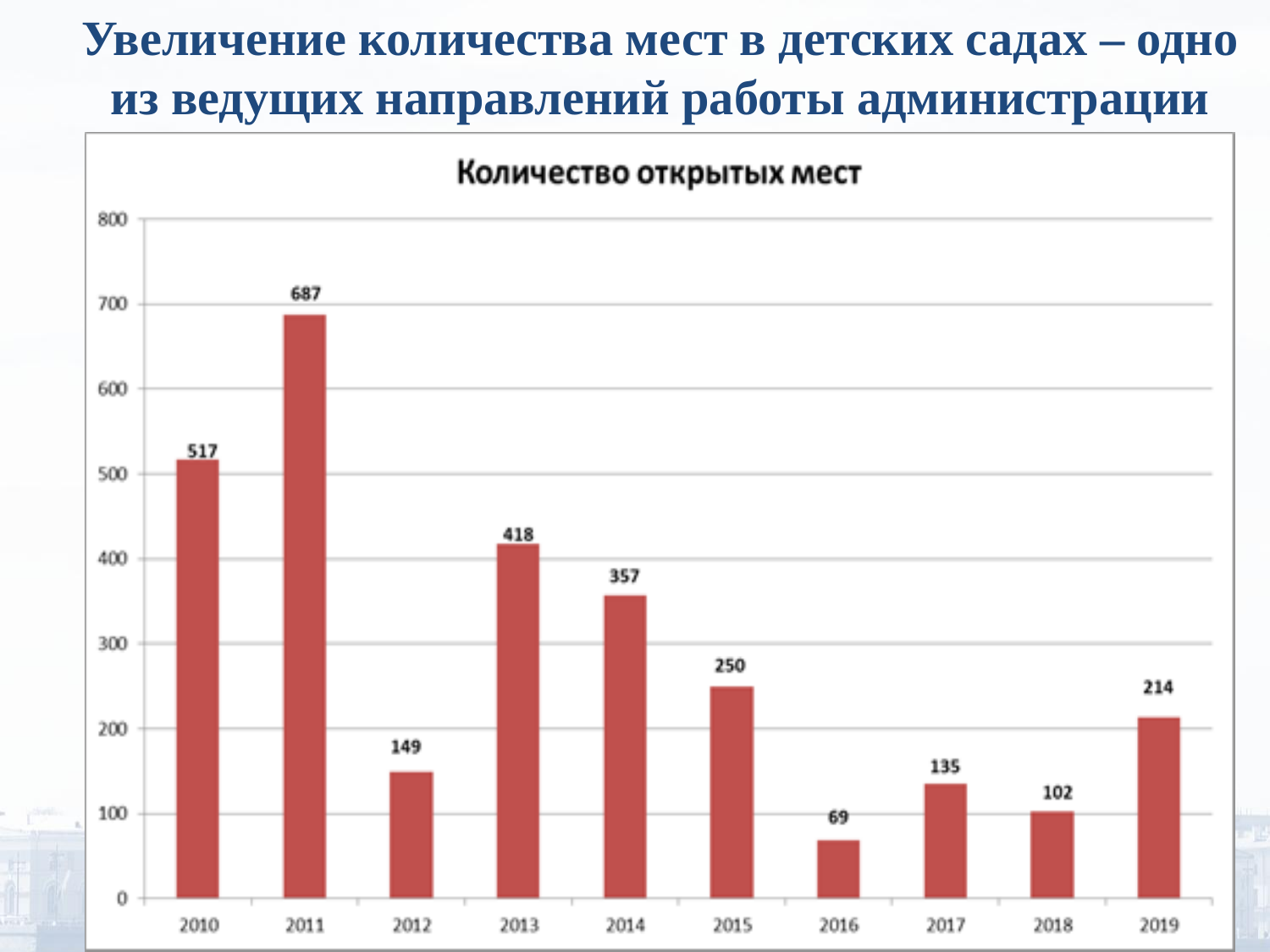
What is the title of the chart? Количество открытых мест Which year has the lowest value? 2016 What is the value for 2016? 69 Is the value for 2012 greater or less than 200? less What is the value for 2011? 687 What is the difference between the values for 2013 and 2014? 61 Which year has the highest value? 2011 What kind of chart is this? bar chart What is the difference between the values for 2011 and 2010? 170 Which is larger, the value for 2015 or the value for 2019? 2015 How many years are shown on the x axis? 10 What is the value for 2019? 214